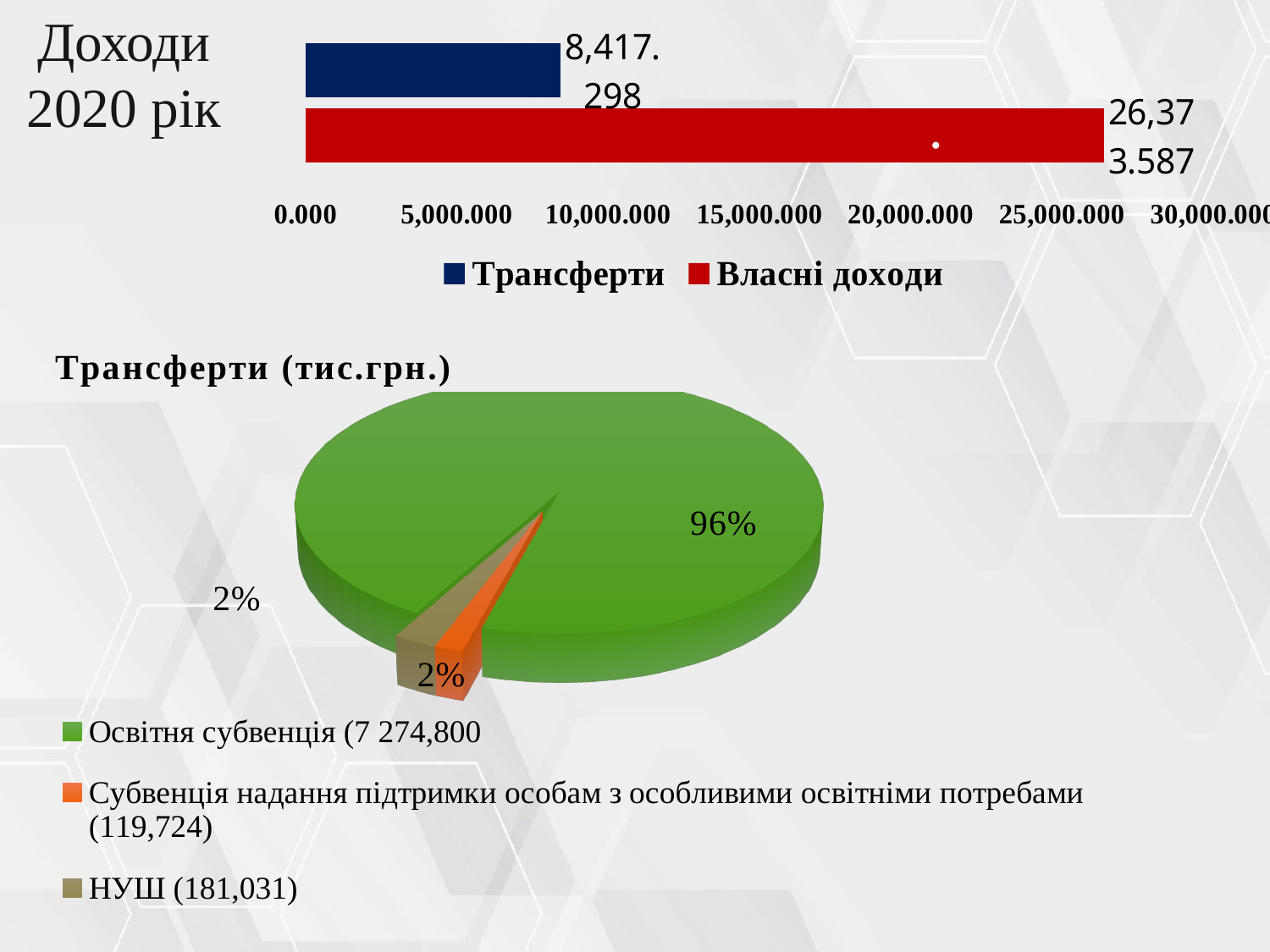
In the bar chart at the top of the slide, is the value for Трансферти greater or less than 10,000.000? less In the bar chart at the top of the slide, what is the value for Трансферти? 8,417.298 How many series does the legend of the bar chart at the top of the slide list? 2 In the pie chart titled 'Трансферти (тис.грн.)', which category has the largest slice? Освітня субвенція In the bar chart at the top of the slide, what is the value for Власні доходи? 26,373.587 In the pie chart titled 'Трансферти (тис.грн.)', what share does Освітня субвенція have? 96% What kind of chart is the chart at the top of the slide? bar chart In the bar chart at the top of the slide, which series has the larger value, Трансферти or Власні доходи? Власні доходи How many categories does the legend of the pie chart titled 'Трансферти (тис.грн.)' list? 3 What kind of chart is the chart titled 'Трансферти (тис.грн.)'? pie chart In the bar chart at the top of the slide, is the value for Власні доходи greater or less than 25,000.000? greater In the pie chart titled 'Трансферти (тис.грн.)', what value is shown in the legend for НУШ? 181,031